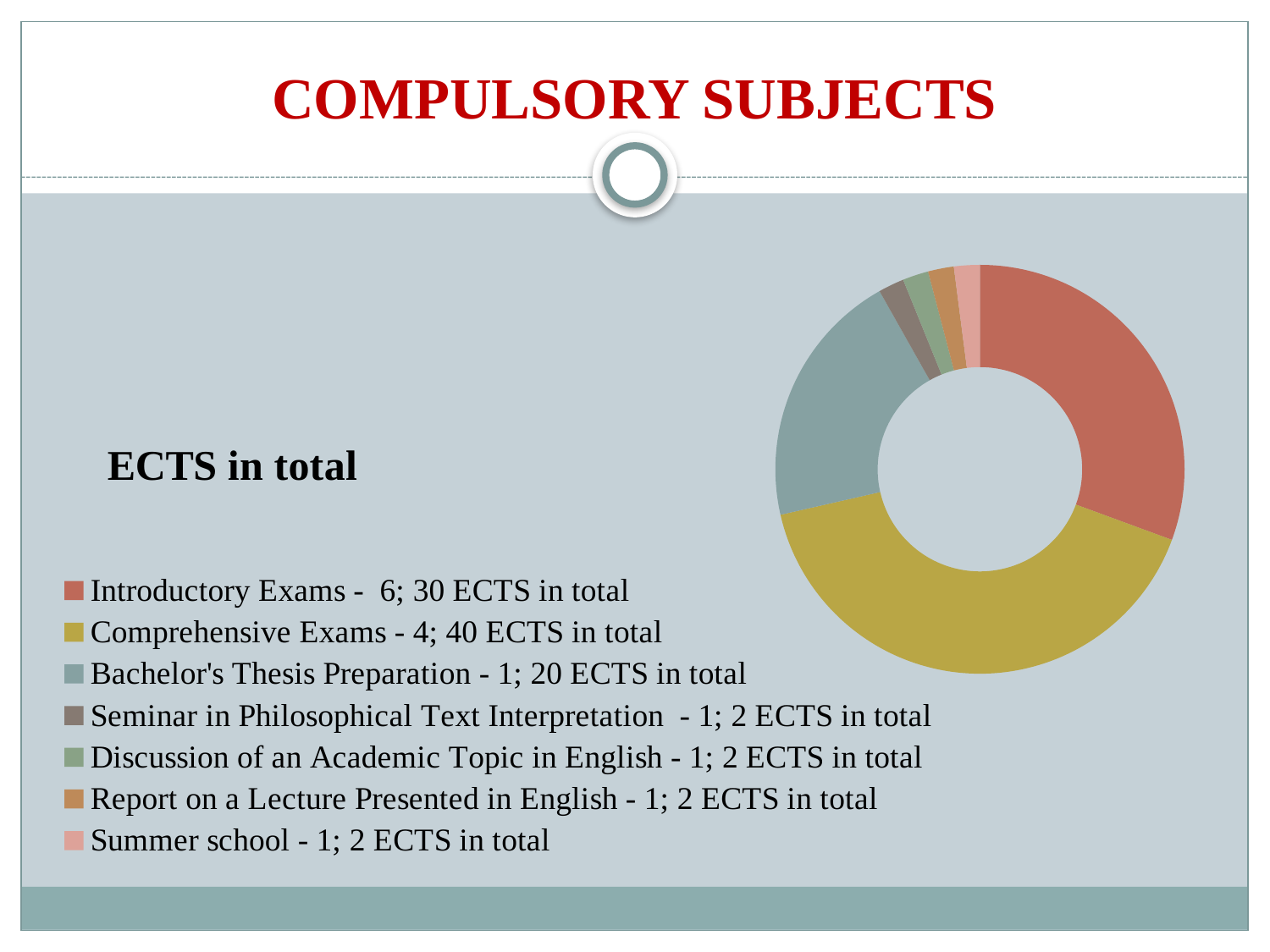
What is the difference in ECTS between Comprehensive Exams and Bachelor's Thesis Preparation? 20 ECTS What is the difference in ECTS between Comprehensive Exams and Introductory Exams? 10 ECTS What kind of chart is shown on the slide? Doughnut chart Which has more ECTS in total, Introductory Exams or Bachelor's Thesis Preparation? Introductory Exams How many ECTS in total are shown for Summer school? 2 ECTS What colour represents Comprehensive Exams in the chart? Yellow How many categories does the chart's legend list? 7 How many ECTS in total are shown for Bachelor's Thesis Preparation? 20 ECTS What is the title of the chart? ECTS in total How many ECTS in total are shown for Comprehensive Exams? 40 ECTS Which category has the largest share of the chart? Comprehensive Exams How many ECTS in total are shown for Introductory Exams? 30 ECTS